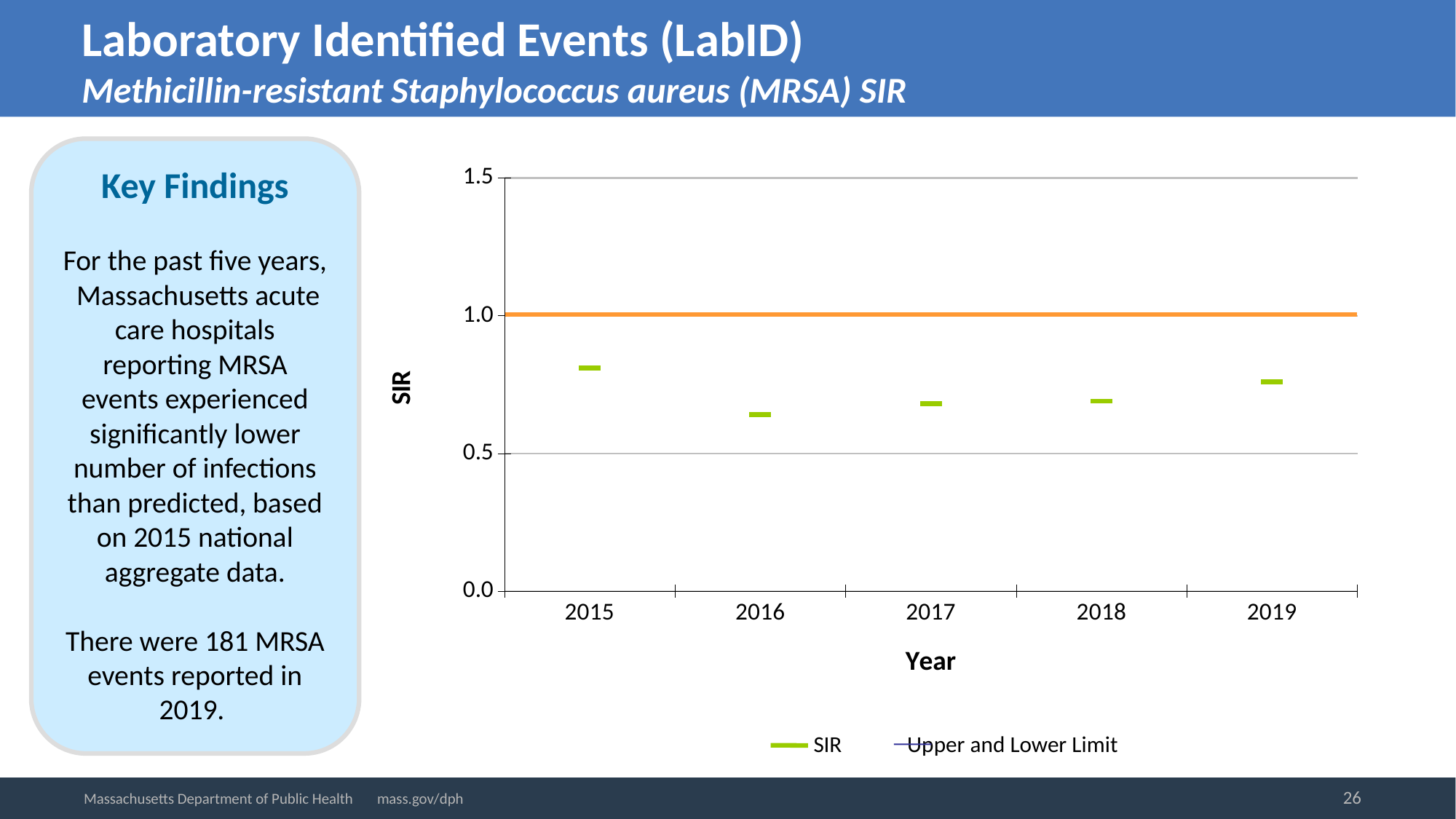
How many series does the chart's legend list? 2 Is the SIR value for 2019 greater or less than 1.0? less Which year has the lowest SIR value in the chart? 2016 Do the SIR values rise or fall from 2016 to 2019? rise What is the title of the chart's x axis? Year At what SIR value does the orange 'Upper and Lower Limit' line sit on the y axis? 1.0 Which year has a larger SIR value, 2016 or 2019? 2019 Is the SIR value for 2016 greater or less than 0.5? greater Which year has a larger SIR value, 2015 or 2016? 2015 Which year has the highest SIR value in the chart? 2015 Is the SIR value for 2015 greater or less than 1.0? less How many years are plotted on the x axis of the chart? 5